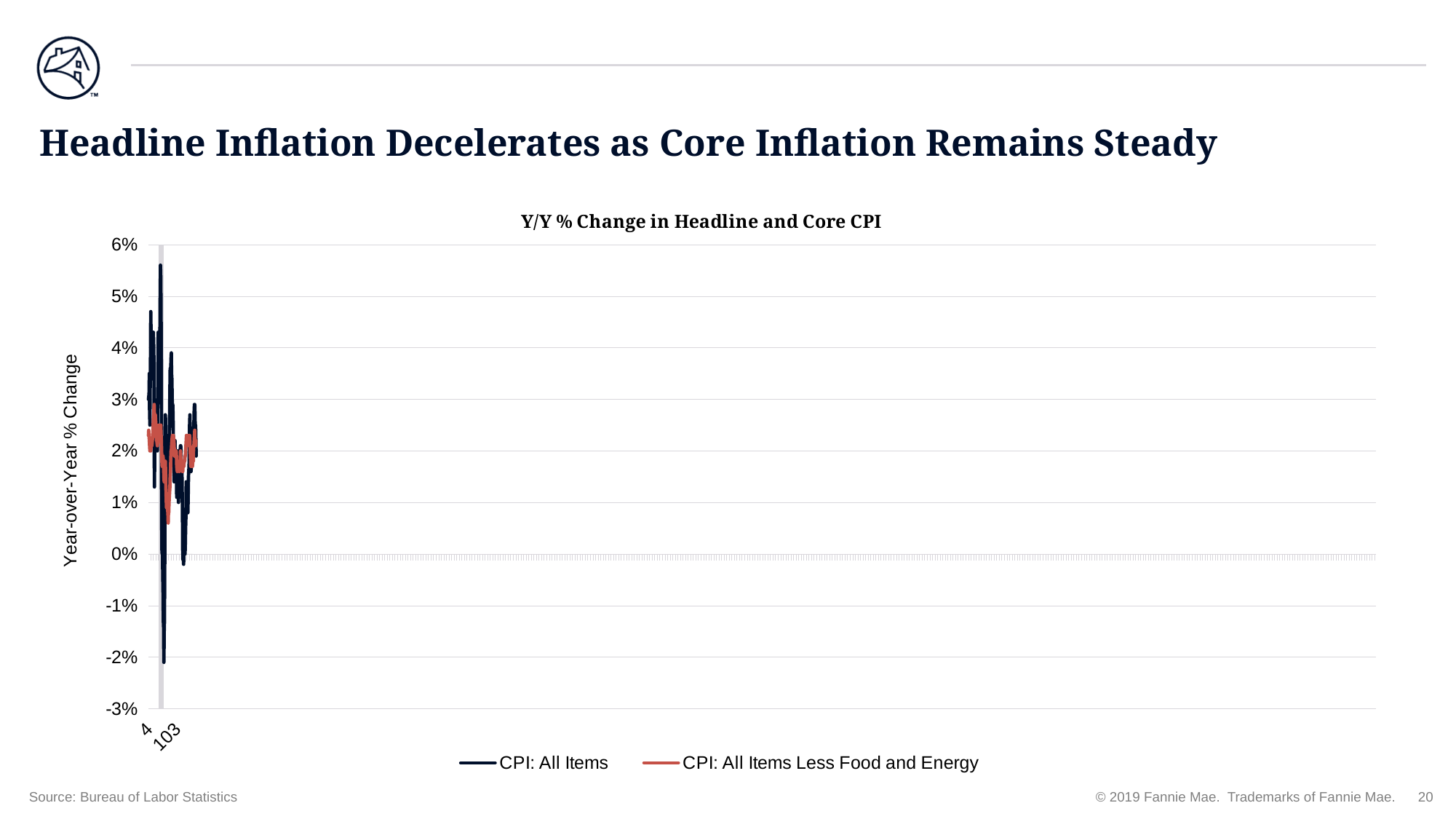
What is the lowest value shown on the y-axis? -3% What is the highest value shown on the y-axis? 6% What kind of chart is shown on the slide? Line chart Is the lowest value reached by the CPI: All Items line greater or less than -1%? less Is the highest value reached by the CPI: All Items line greater or less than 5%? greater Is the highest value reached by the CPI: All Items Less Food and Energy line greater or less than 4%? less How many series does the legend list? 2 Which series reaches the lower minimum value, CPI: All Items or CPI: All Items Less Food and Energy? CPI: All Items What are the two series named in the legend? CPI: All Items; CPI: All Items Less Food and Energy Which series reaches the higher peak value, CPI: All Items or CPI: All Items Less Food and Energy? CPI: All Items